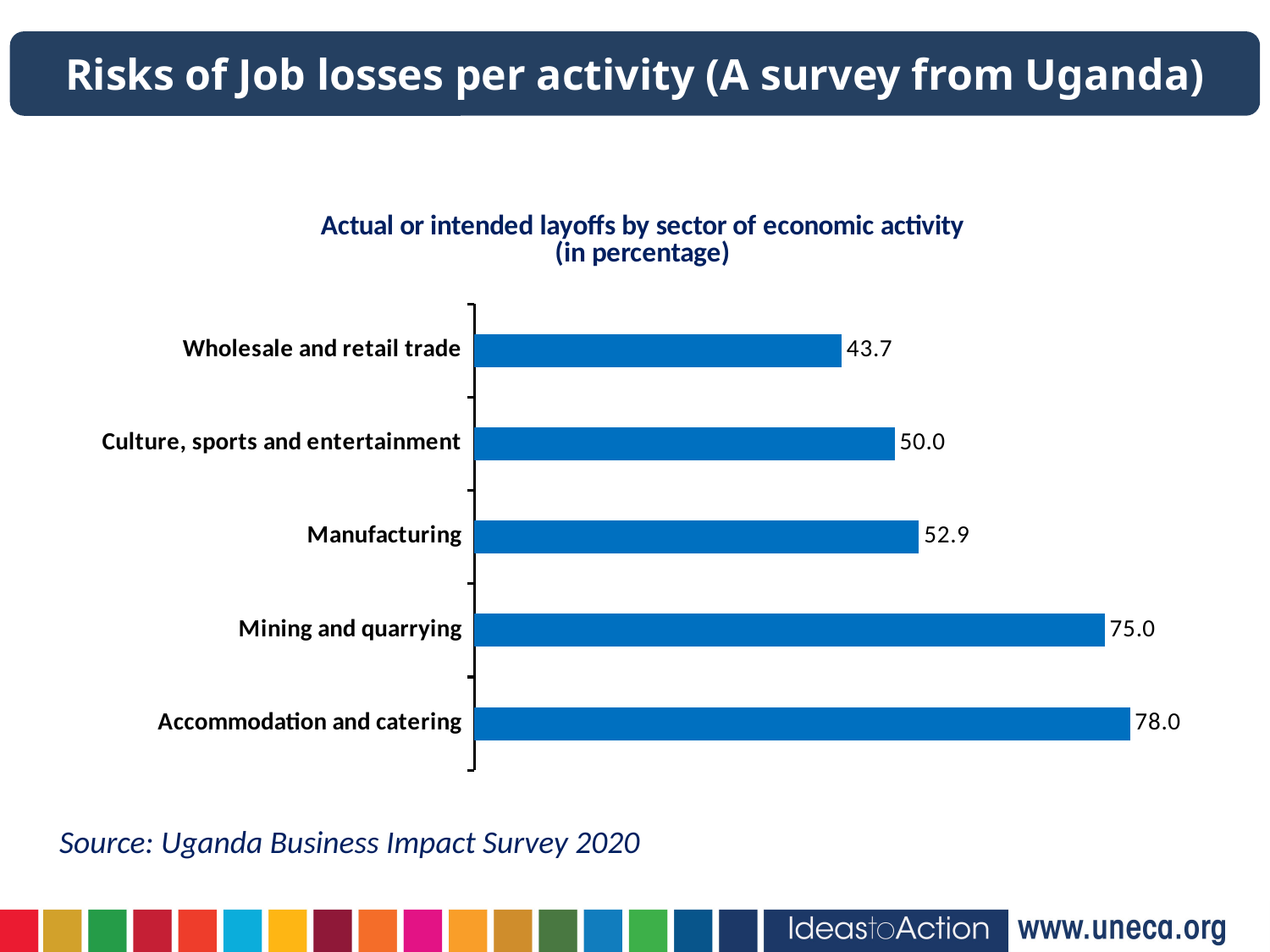
What is the value for Manufacturing? 52.9 What is the difference between the values for Accommodation and catering and Wholesale and retail trade? 34.3 What is the value for Accommodation and catering? 78.0 What is the value for Wholesale and retail trade? 43.7 Which sector has the lowest value? Wholesale and retail trade Which is larger, the value for Culture, sports and entertainment or the value for Manufacturing? Manufacturing What kind of chart is shown on the slide? Bar chart What is the difference between the values for Mining and quarrying and Manufacturing? 22.1 What is the value for Mining and quarrying? 75.0 How many sectors are shown in the chart? 5 Which sector has the highest value? Accommodation and catering What is the title of the chart? Actual or intended layoffs by sector of economic activity (in percentage)